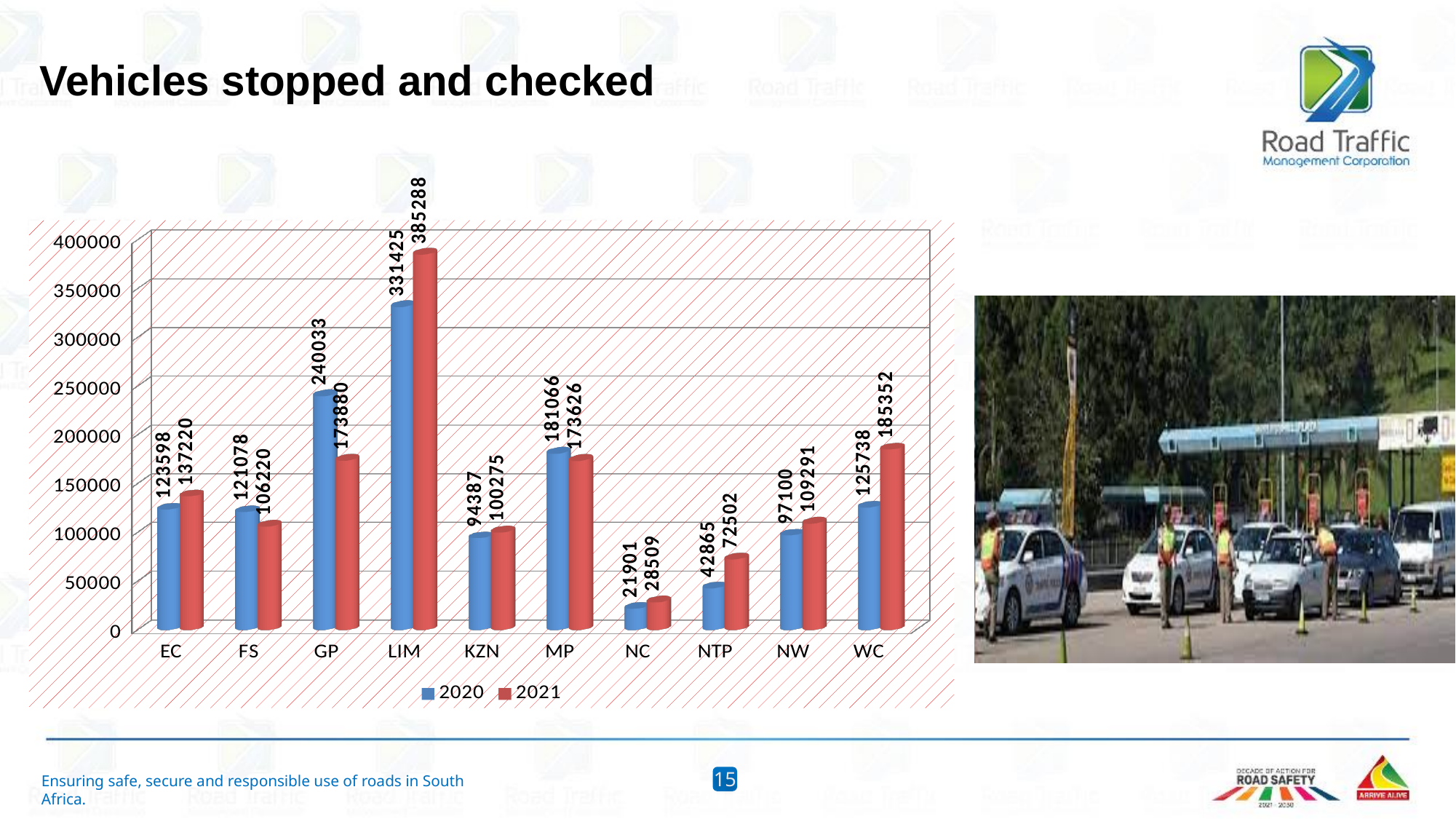
How many provinces are shown on the x axis? 10 What was the value for NTP in 2021? 72502 What was the value for LIM in 2021? 385288 How many series does the legend list? 2 What is the title of the slide containing the chart? Vehicles stopped and checked What was the value for GP in 2020? 240033 Is the value for MP in 2020 greater or less than 150000? greater Which province had the highest number of vehicles stopped and checked in 2021? LIM For GP, which year had the larger value, 2020 or 2021? 2020 What kind of chart is shown on the slide? Bar chart Which province had the lowest number of vehicles stopped and checked in 2020? NC What is the difference between the 2021 and 2020 values for WC? 59614